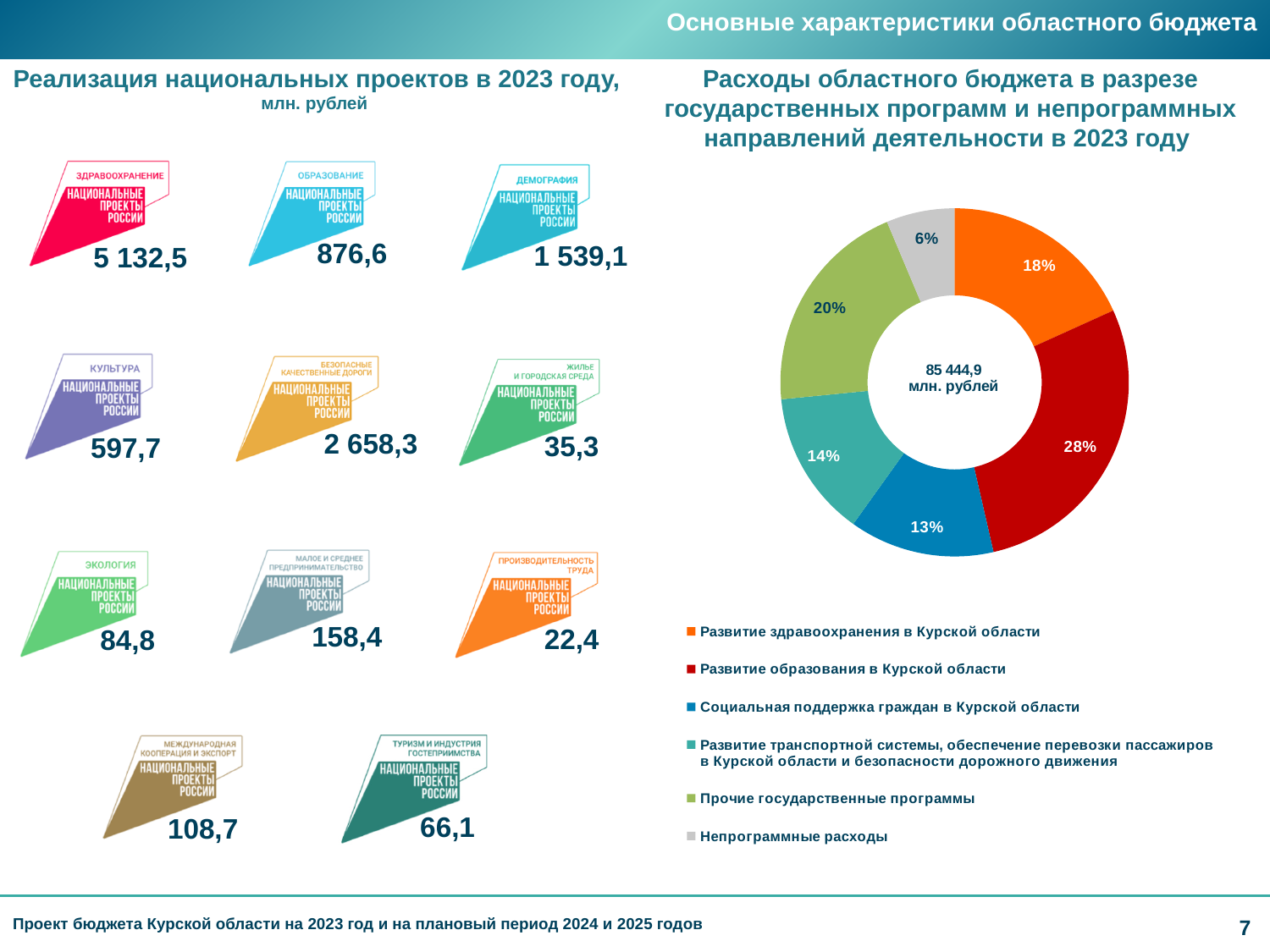
What share of the 2023 regional budget expenditure goes to "Развитие образования в Курской области"? 28% How many entries does the legend of the pie chart list? 6 In the pie chart, how many percentage points larger is the share of "Развитие образования в Курской области" than the share of "Развитие здравоохранения в Курской области"? 10 What total amount is printed in the centre of the pie chart? 85 444,9 млн. рублей What share of the 2023 regional budget expenditure is "Непрограммные расходы"? 6% What share of the 2023 regional budget expenditure goes to "Социальная поддержка граждан в Курской области"? 13% Which category has the smallest share in the pie chart of regional budget expenditure in 2023? Непрограммные расходы How many slices does the pie chart of regional budget expenditure in 2023 have? 6 What share of the 2023 regional budget expenditure goes to "Развитие здравоохранения в Курской области"? 18% In the pie chart, which has the larger share: "Прочие государственные программы" or "Развитие транспортной системы, обеспечение перевозки пассажиров в Курской области и безопасности дорожного движения"? Прочие государственные программы What type of chart is used to show the regional budget expenditure by state programmes in 2023? doughnut chart Which category has the largest share in the pie chart of regional budget expenditure in 2023? Развитие образования в Курской области